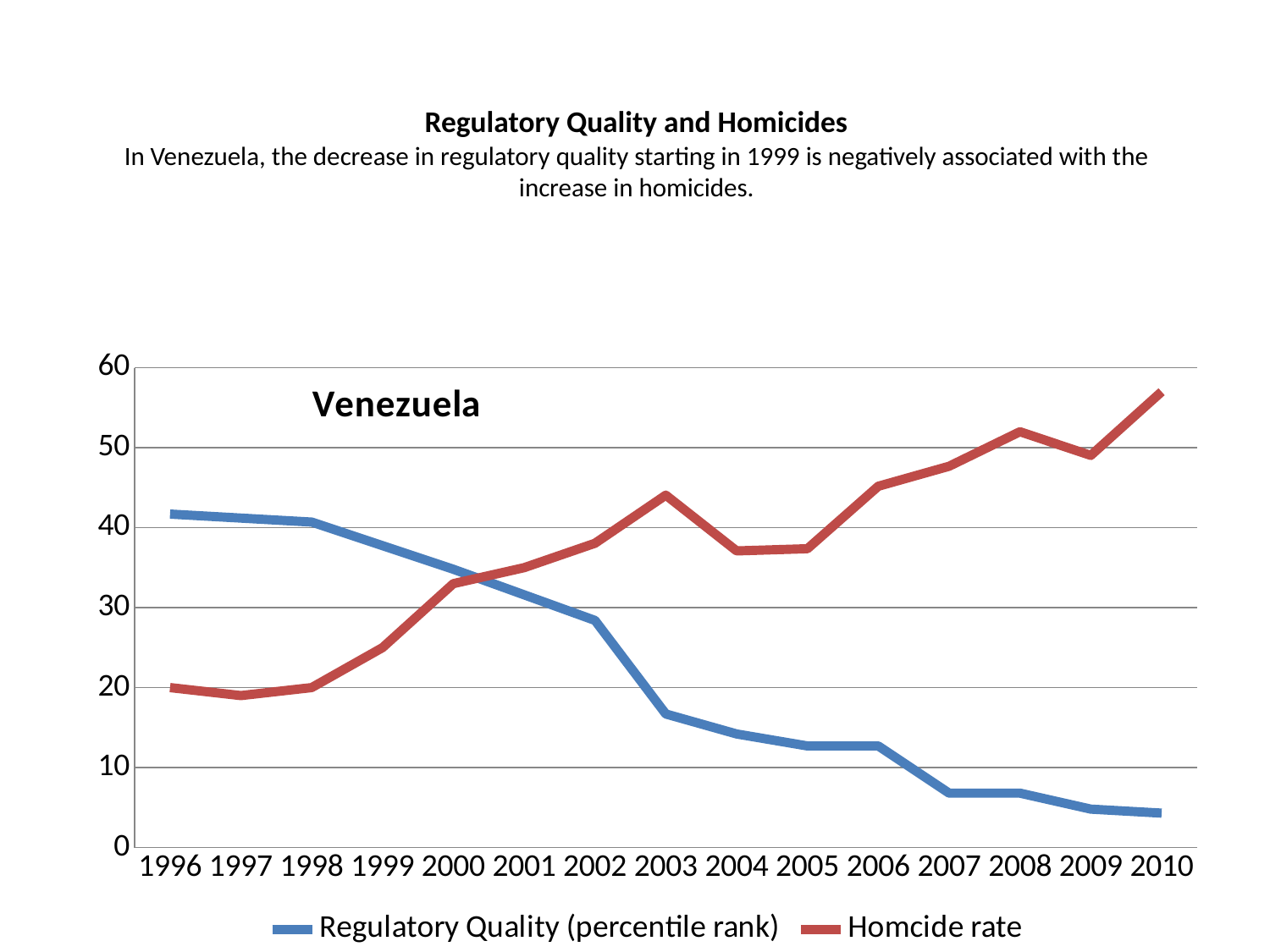
Does the Homcide rate line rise or fall overall from 1996 to 2010? rise Does the Regulatory Quality (percentile rank) line rise or fall from 1996 to 2010? fall In 2010, which is larger: the Homcide rate or the Regulatory Quality (percentile rank)? Homcide rate Is the Regulatory Quality (percentile rank) in 2003 greater or less than 20? less In which year is the Homcide rate highest? 2010 Is the Homcide rate in 1996 greater or less than 30? less Is the Homcide rate in 2010 greater or less than 50? greater How many series does the legend list? 2 Which country name is printed inside the chart area? Venezuela How many years are plotted along the x axis? 15 What kind of chart is shown on the slide? line chart